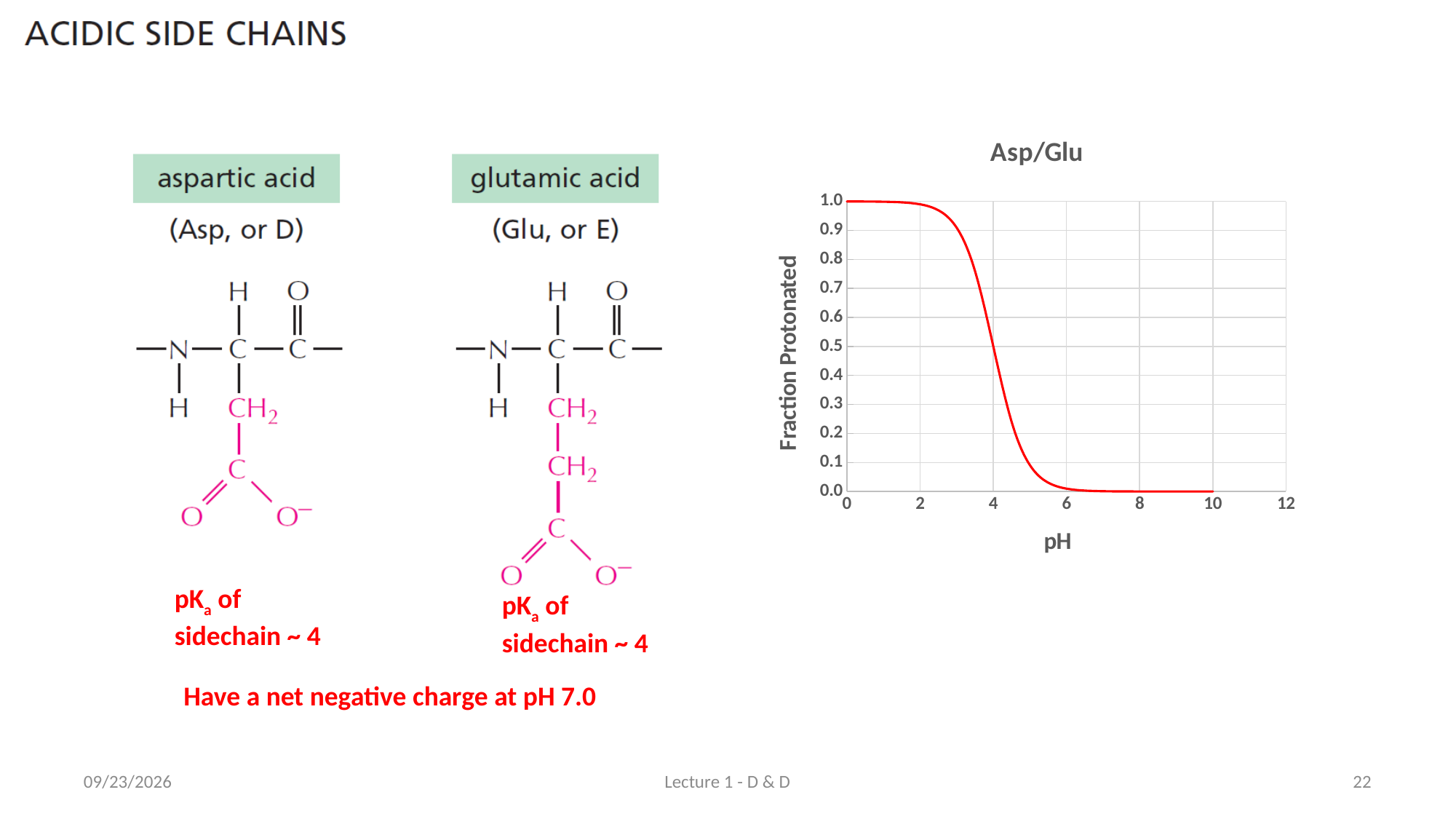
Is the fraction protonated at pH 6 greater or less than 0.1? less What is the label of the y axis of the chart? Fraction Protonated Does the fraction protonated rise or fall as pH increases along the x axis? fall What is the highest pH value shown on the x axis of the chart? 12 Is the fraction protonated at pH 1 greater or less than 0.9? greater What is the title of the chart? Asp/Glu Is the fraction protonated at pH 8 greater or less than 0.1? less Which has the larger fraction protonated, pH 2 or pH 6? pH 2 Which has the larger fraction protonated, pH 10 or pH 1? pH 1 What kind of chart is shown on the slide? line chart